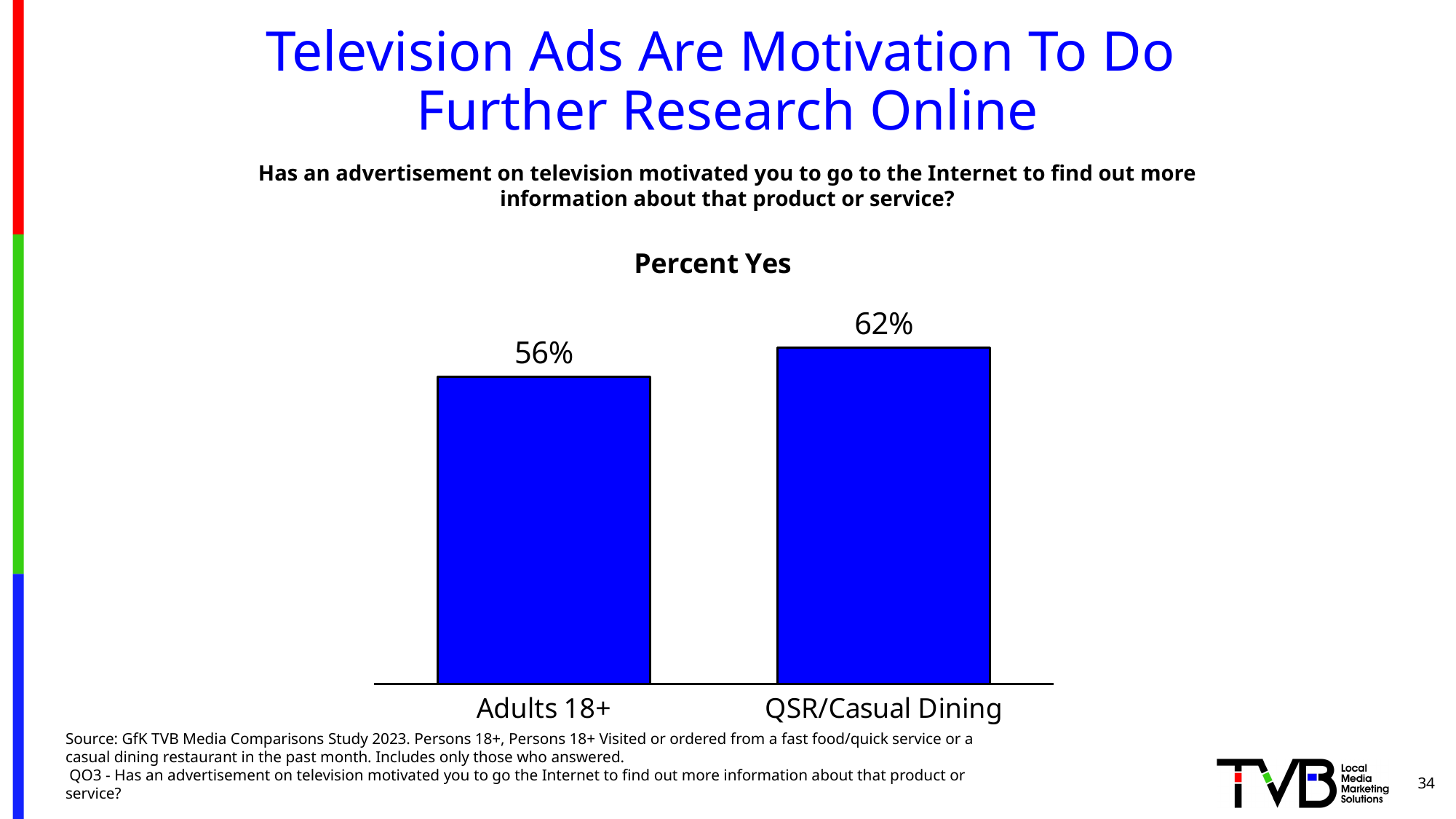
What kind of chart is shown on the slide? Bar chart Which category has the higher Percent Yes value? QSR/Casual Dining What is the Percent Yes value for Adults 18+? 56% What colour are the bars in the chart? Blue Is the Percent Yes value larger for Adults 18+ or for QSR/Casual Dining? QSR/Casual Dining Which category has the lower Percent Yes value? Adults 18+ What is the title of the chart? Percent Yes What is the Percent Yes value for QSR/Casual Dining? 62% How many categories are shown in the chart? 2 What is the difference in Percent Yes between QSR/Casual Dining and Adults 18+? 6%